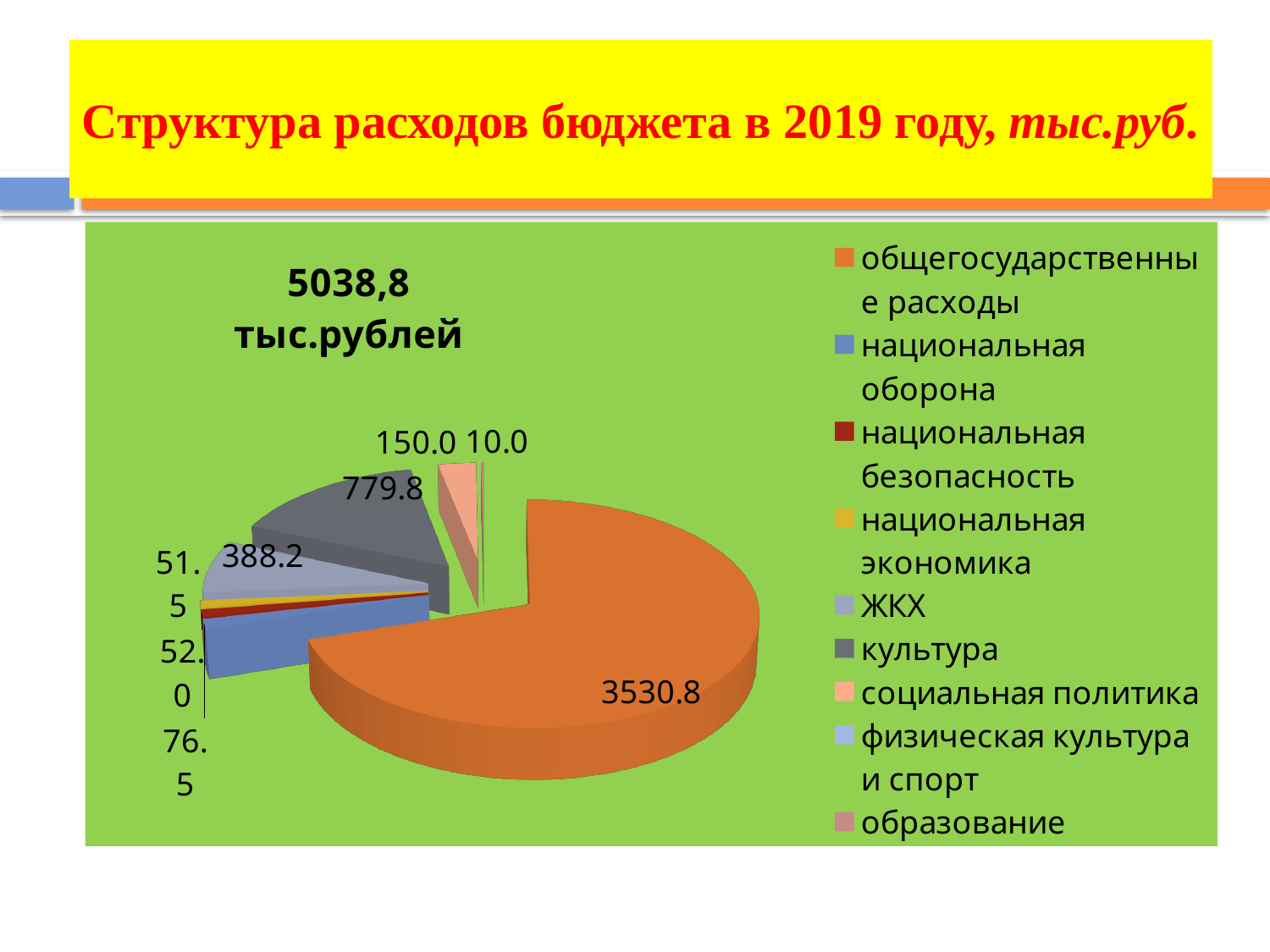
What is the value for культура? 779.8 What total is printed above the pie chart? 5038,8 тыс.рублей How many entries does the legend list? 9 What colour is the slice for общегосударственные расходы? Orange What is the value for ЖКХ? 388.2 What is the value for социальная политика? 150.0 Which category has the largest slice of the pie? общегосударственные расходы What is the difference between the values for культура and ЖКХ? 391.6 What is the value for общегосударственные расходы? 3530.8 What kind of chart is shown on the slide? Pie chart Which is larger, the value for культура or the value for ЖКХ? культура